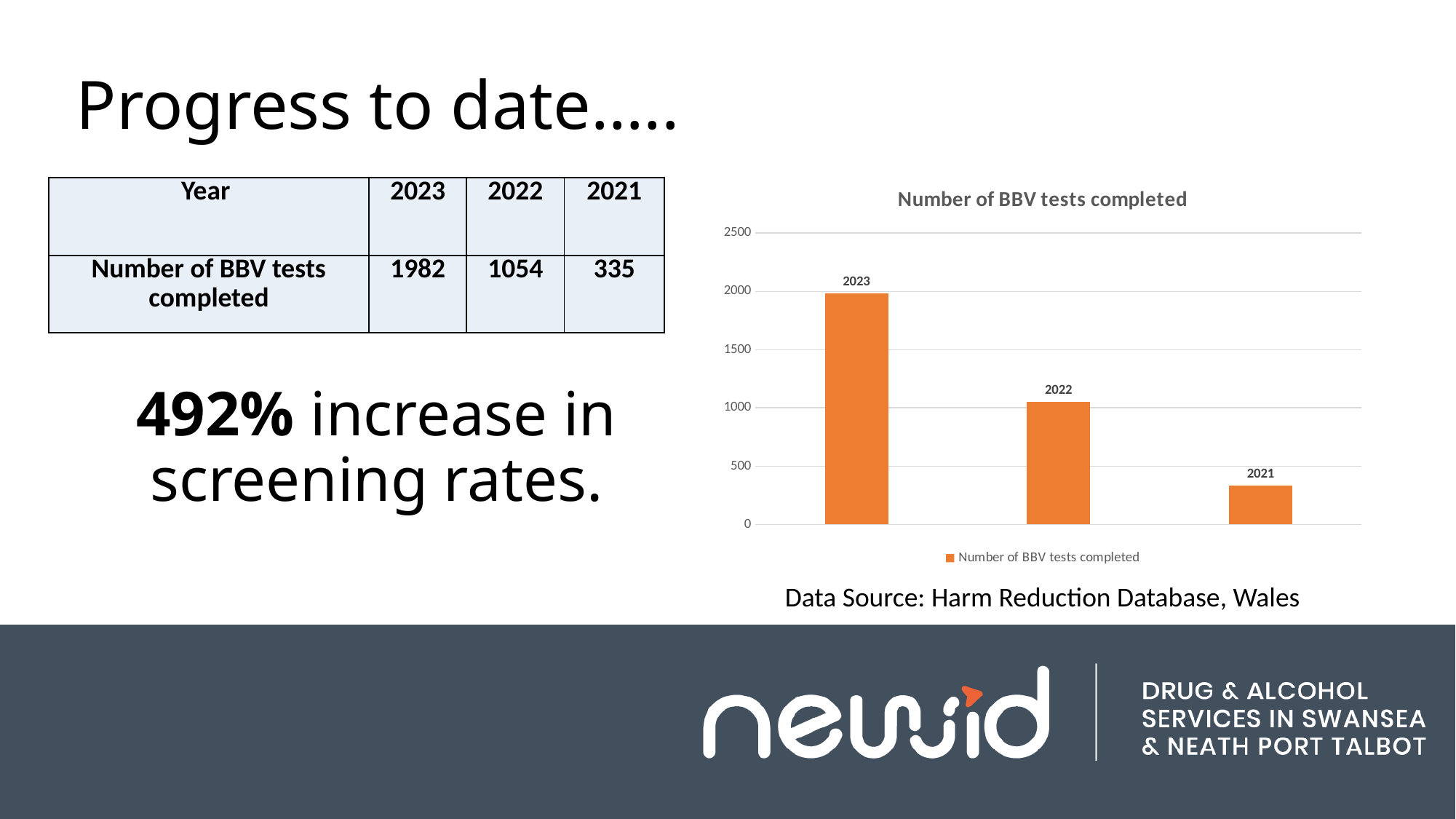
Which year has the lowest number of BBV tests completed? 2021 What is the title of the chart? Number of BBV tests completed What is the difference between the number of BBV tests completed in 2023 and in 2021? 1647 What kind of chart is shown on the slide? bar chart Which is larger, the number of BBV tests completed in 2022 or in 2021? 2022 How many series does the chart legend list? 1 How many bars does the chart have? 3 Which year has the highest number of BBV tests completed? 2023 Is the value for 2022 greater or less than 1000? greater Is the value for 2023 greater or less than 1500? greater Do the bar values rise or fall moving left to right along the x axis? fall Is the value for 2021 greater or less than 500? less